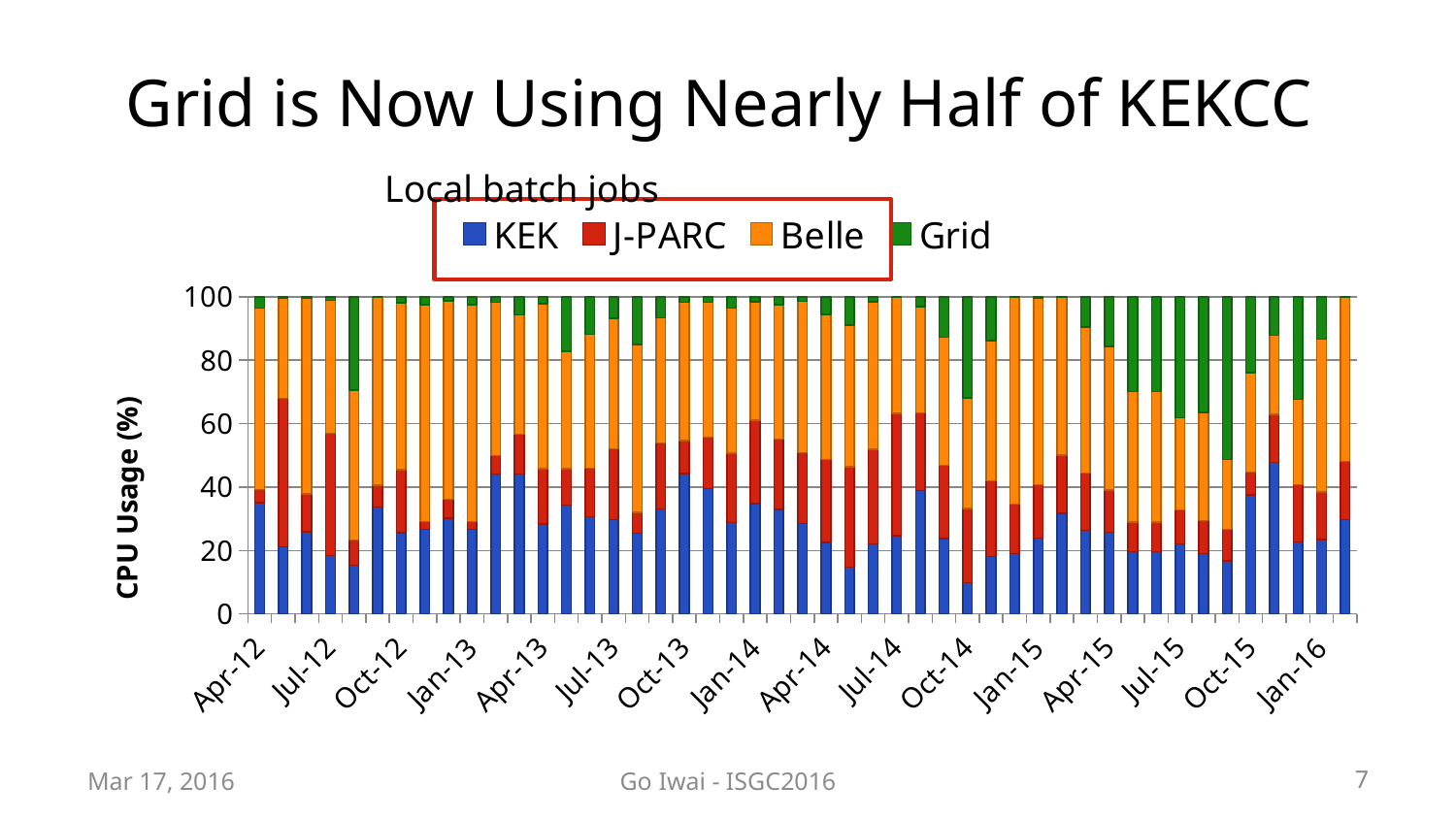
What kind of chart is shown on the slide? Stacked bar chart Which is larger, the Grid portion of the bar at Oct-15 or the Grid portion of the bar at Apr-12? Oct-15 How many series does the legend list? 4 Does the Grid share of CPU usage generally rise or fall from Apr-12 to Jan-16? rise What is the label of the vertical axis? CPU Usage (%) What is the last date label on the x axis? Jan-16 Which series is shown in green? Grid Is the KEK value for Apr-12 greater or less than 20? greater Which series are listed in the legend? KEK, J-PARC, Belle, Grid What is the first date label on the x axis? Apr-12 How many date labels are shown along the x axis? 16 Is the KEK value for Oct-14 greater or less than 20? less